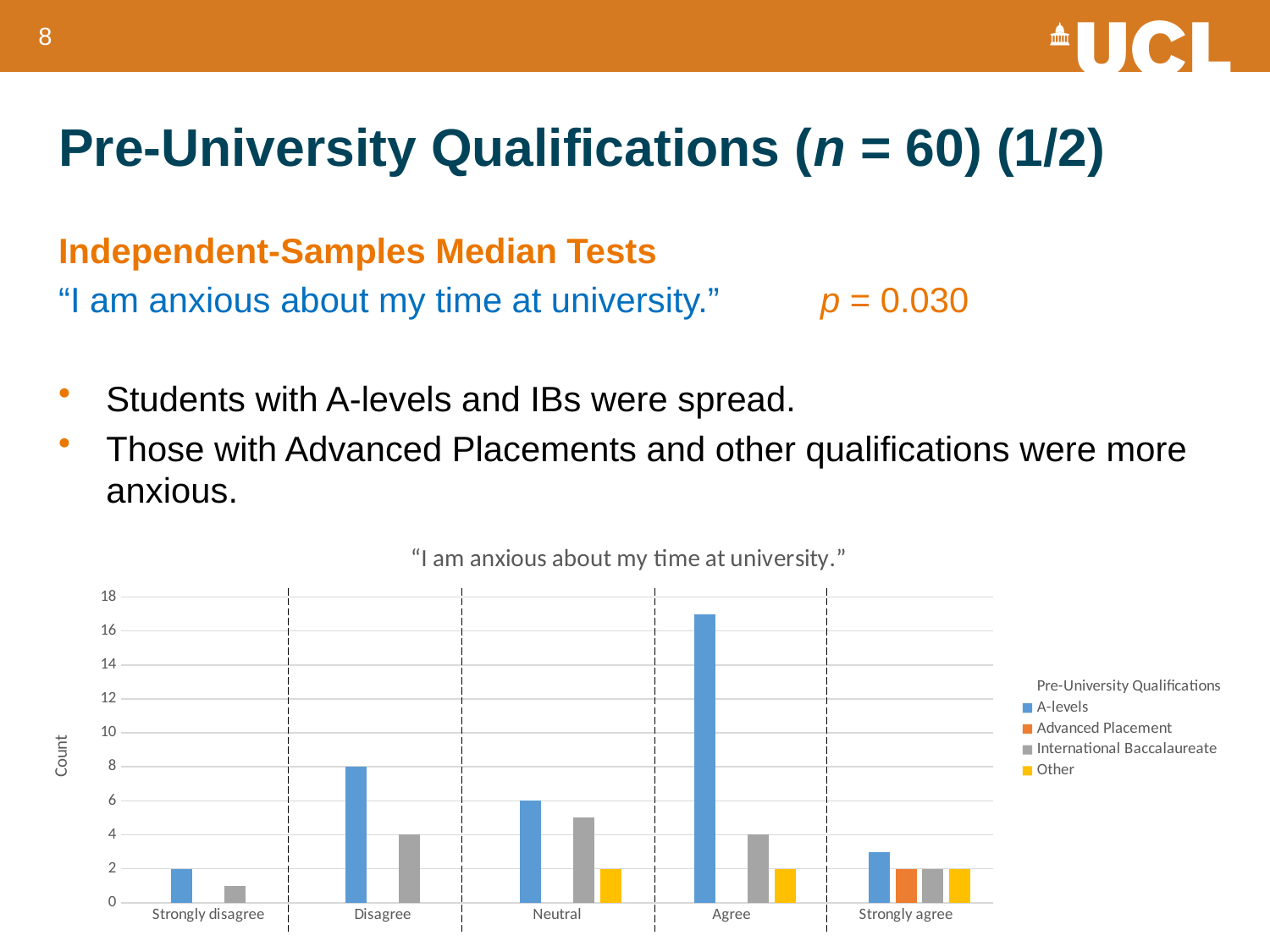
What is the count for Advanced Placement in the Strongly agree category? 2 What is the count for A-levels in the Disagree category? 8 How many series does the chart legend list? 4 Which is larger in the Disagree category, the A-levels count or the International Baccalaureate count? A-levels Is the count for A-levels in the Agree category greater or less than 10? greater What is the count for International Baccalaureate in the Disagree category? 4 What is the title of the chart? "I am anxious about my time at university." What type of chart is shown on the slide? bar chart What is the difference between the A-levels count and the International Baccalaureate count in the Disagree category? 4 How many response categories are shown on the x axis? 5 Which category has the highest count for A-levels? Agree What is the count for A-levels in the Neutral category? 6